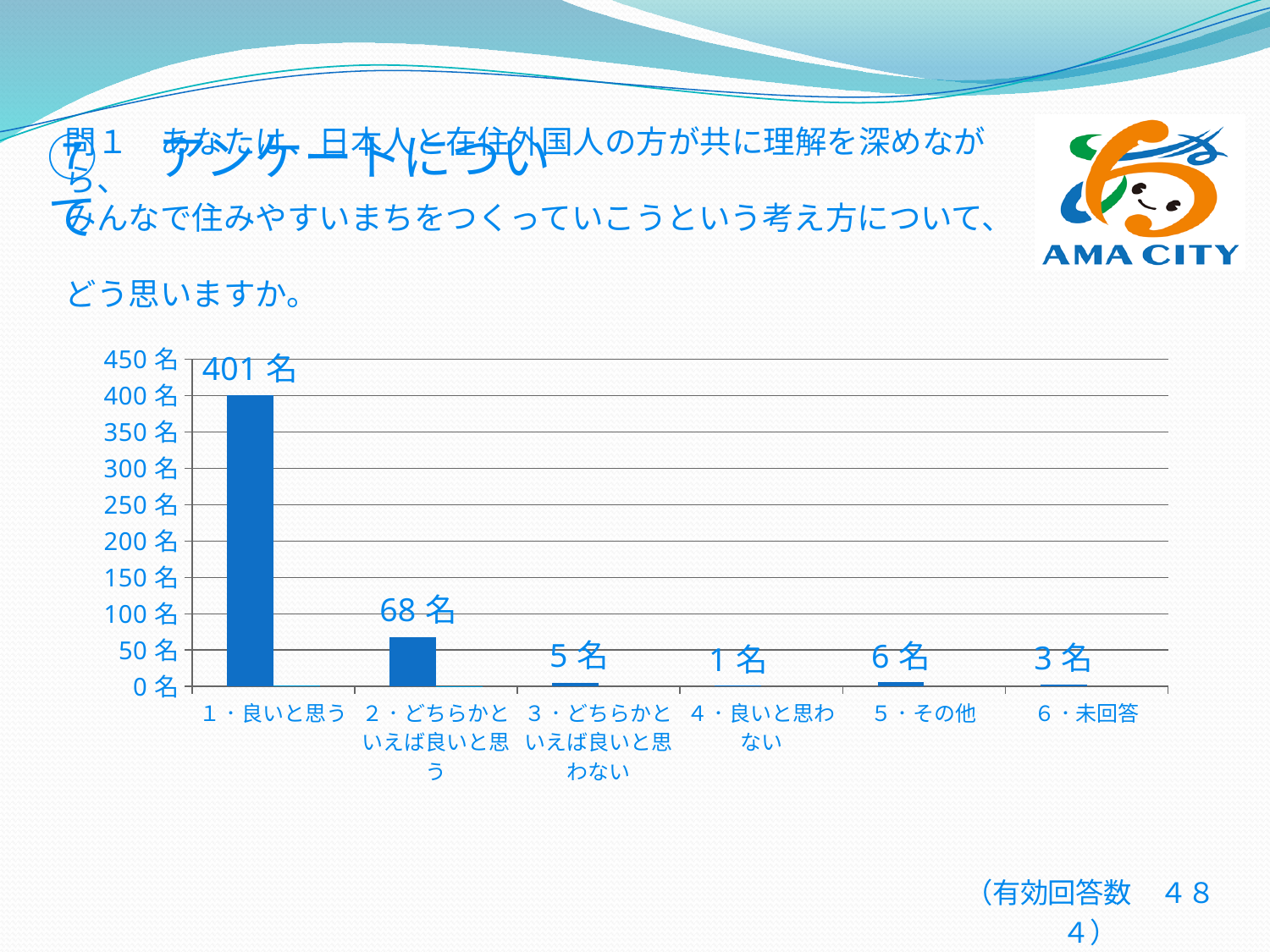
What is the value for 「2・どちらかといえば良いと思う」? 68名 How many categories are shown on the x axis? 6 What kind of chart is shown on the slide? Bar chart What is the value for 「3・どちらかといえば良いと思わない」? 5名 What is the value for 「6・未回答」? 3名 Which is larger, the value for 「5・その他」 or the value for 「6・未回答」? 5・その他 Which category has the lowest value? 4・良いと思わない Which category has the highest value? 1・良いと思う What is the value for 「4・良いと思わない」? 1名 What is the difference between the values for 「1・良いと思う」 and 「2・どちらかといえば良いと思う」? 333名 What is the value for 「5・その他」? 6名 What is the value for 「1・良いと思う」? 401名